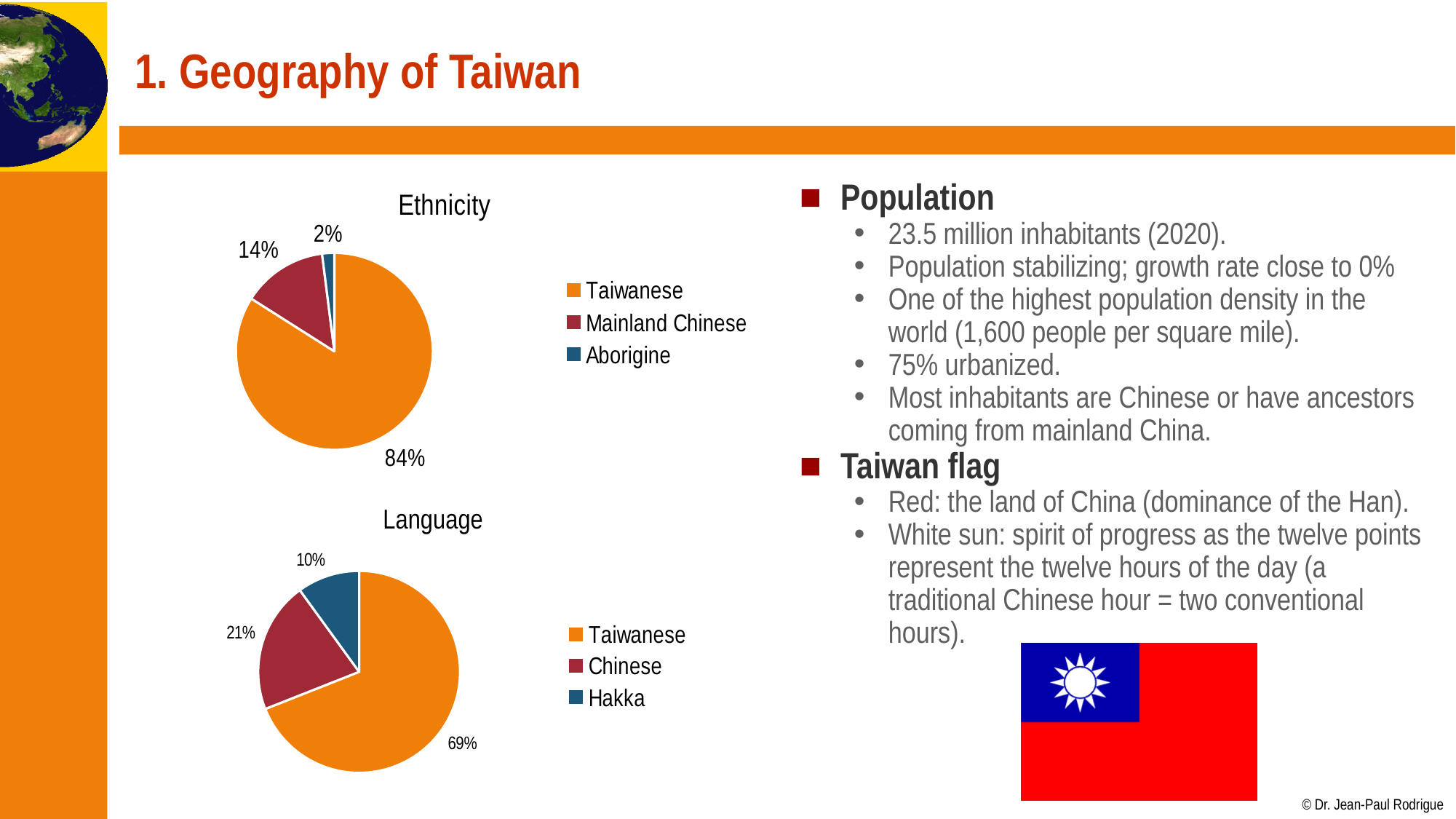
In the Ethnicity chart, which category has the smallest share? Aborigine In the Ethnicity chart, what share of the pie is Aborigine? 2% How many categories does the Language chart's legend list? 3 In the Language chart, what share of the pie is Hakka? 10% In the Language chart, which is larger, the Chinese share or the Hakka share? Chinese In the Ethnicity chart, what share of the pie is Mainland Chinese? 14% What kind of chart is the Ethnicity chart? Pie chart In the Language chart, what share of the pie is Chinese? 21% In the Ethnicity chart, what share of the pie is Taiwanese? 84% In the Language chart, which category has the largest share? Taiwanese In the Ethnicity chart, what is the difference between the Taiwanese and Mainland Chinese shares? 70% In the Language chart, what is the difference between the Taiwanese and Chinese shares? 48%